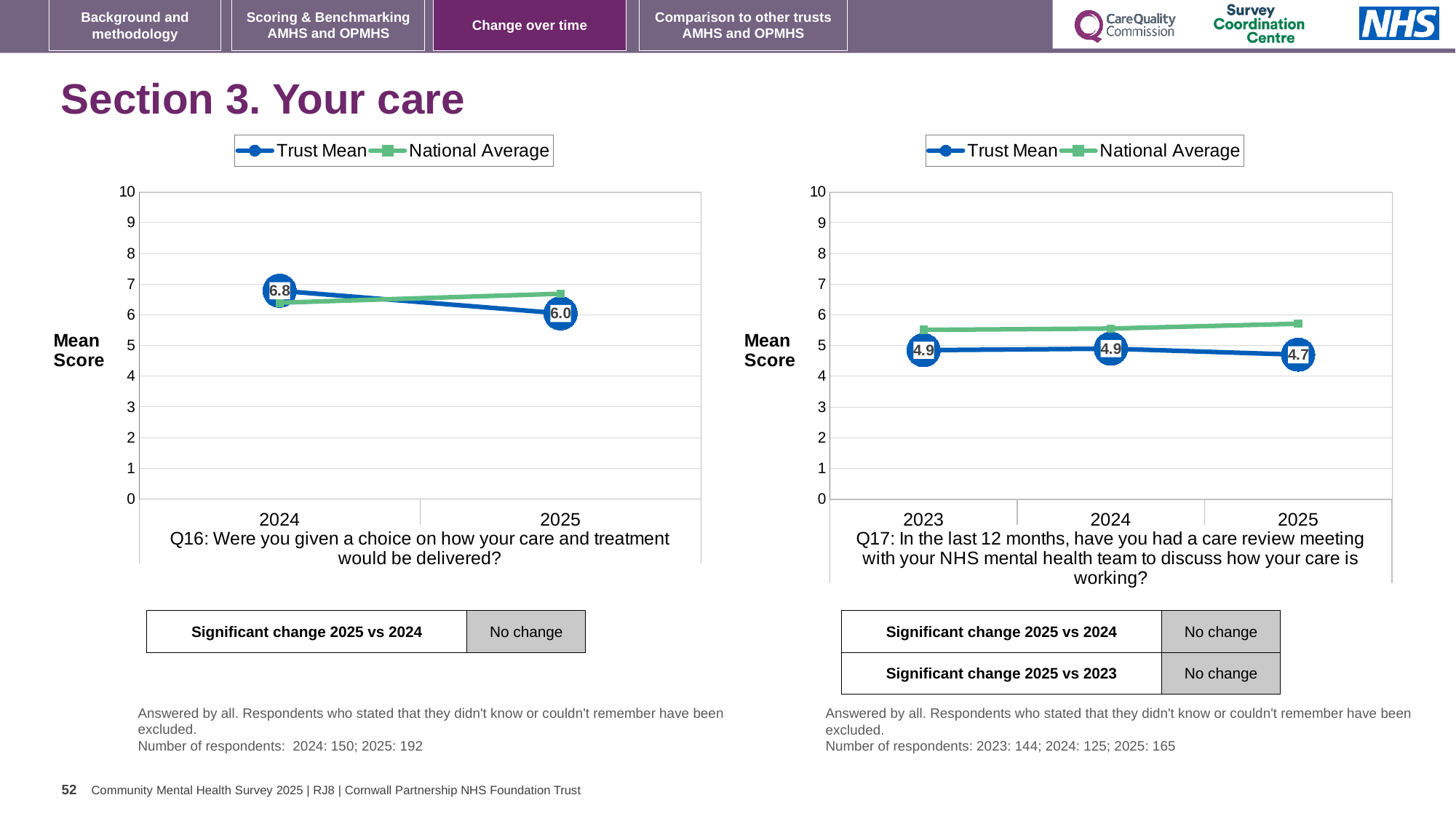
In the Q16 chart on the left, what is the Trust Mean for 2025? 6.0 In the Q17 chart on the right, is the National Average for 2025 greater or less than 5? greater In the Q17 chart on the right, which year has the lowest Trust Mean? 2025 In the Q16 chart on the left, is the National Average for 2025 greater or less than 6? greater In the Q17 chart on the right, which is higher in 2024, the Trust Mean or the National Average? National Average In the Q16 chart on the left, what is the Trust Mean for 2024? 6.8 In the Q16 chart on the left, by how much did the Trust Mean change from 2024 to 2025? 0.8 In the Q16 chart on the left, does the Trust Mean rise or fall from 2024 to 2025? fall In the Q17 chart on the right, what is the Trust Mean for 2025? 4.7 How many series does the legend of the Q16 chart on the left list? 2 In the Q17 chart on the right, what is the Trust Mean for 2023? 4.9 How many years are plotted on the x axis of the Q17 chart on the right? 3